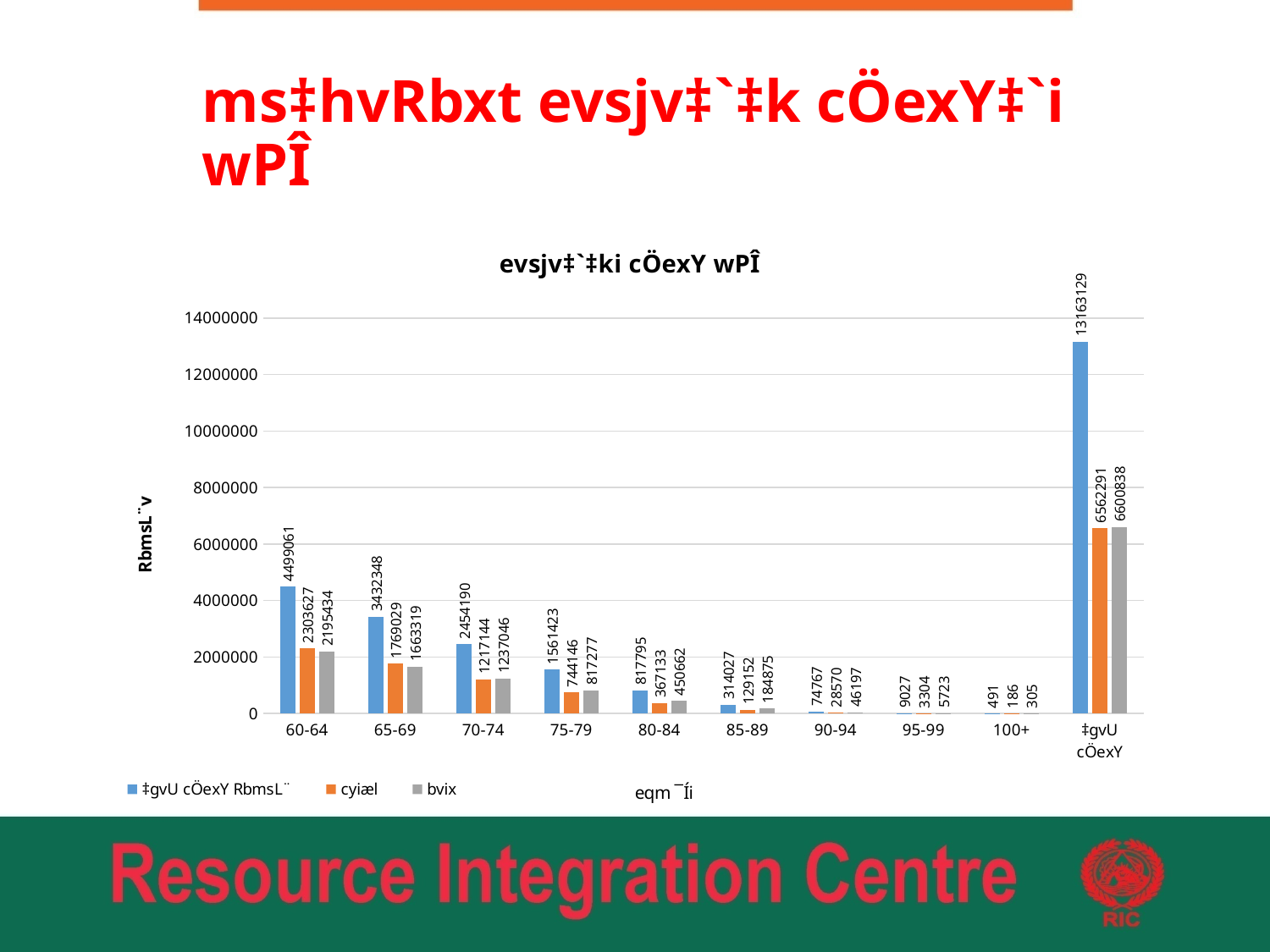
How many categories are shown on the x axis? 10 How many series does the legend list? 3 What is the value of the orange bar for the 70-74 age group? 1217144 What kind of chart is shown on the slide? bar chart Which category has the lowest orange bar? 100+ What is the difference between the orange and gray bars for the 75-79 age group? 73131 What is the value of the blue bar for the 60-64 age group? 4499061 What is the value of the blue bar for the 100+ age group? 491 For the 70-74 age group, which is larger: the orange bar or the gray bar? gray bar Among the age-group categories (excluding the rightmost total category), which has the highest blue bar? 60-64 Is the value of the blue bar for the 65-69 age group greater or less than 4000000? less What is the value of the gray bar for the 85-89 age group? 184875